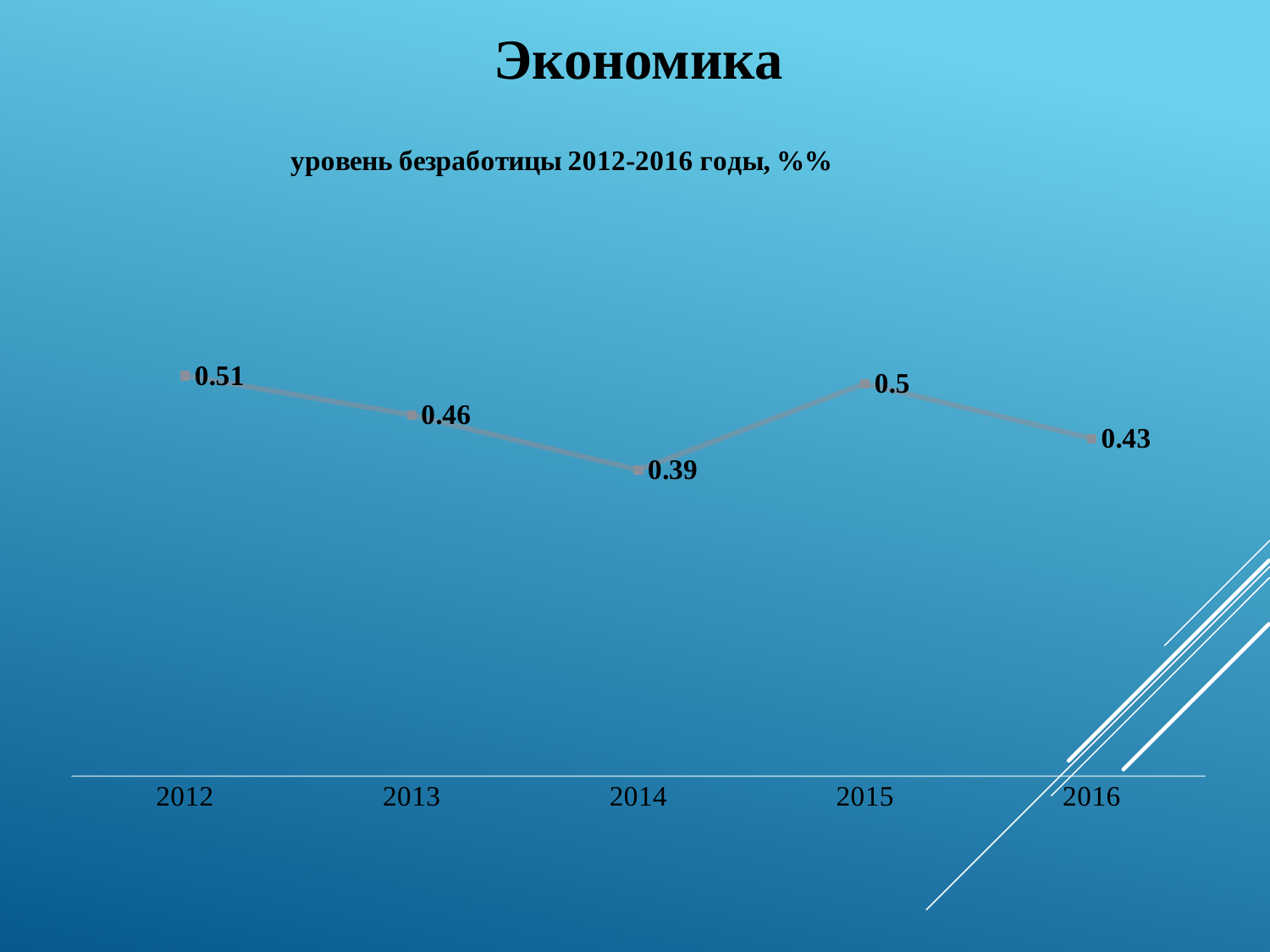
Which year has the highest value on the chart? 2012 Which year has the lowest value on the chart? 2014 Do the values rise or fall from 2012 to 2014? fall What is the difference between the values for 2015 and 2016? 0.07 How many years are plotted on the chart? 5 Which year has a larger value, 2013 or 2015? 2015 What is the unemployment rate value shown for 2012? 0.51 What is the difference between the values for 2012 and 2014? 0.12 What is the value plotted for 2014? 0.39 What is the value plotted for 2016? 0.43 What kind of chart is shown on the slide? line chart What is the title of the chart? уровень безработицы 2012-2016 годы, %%